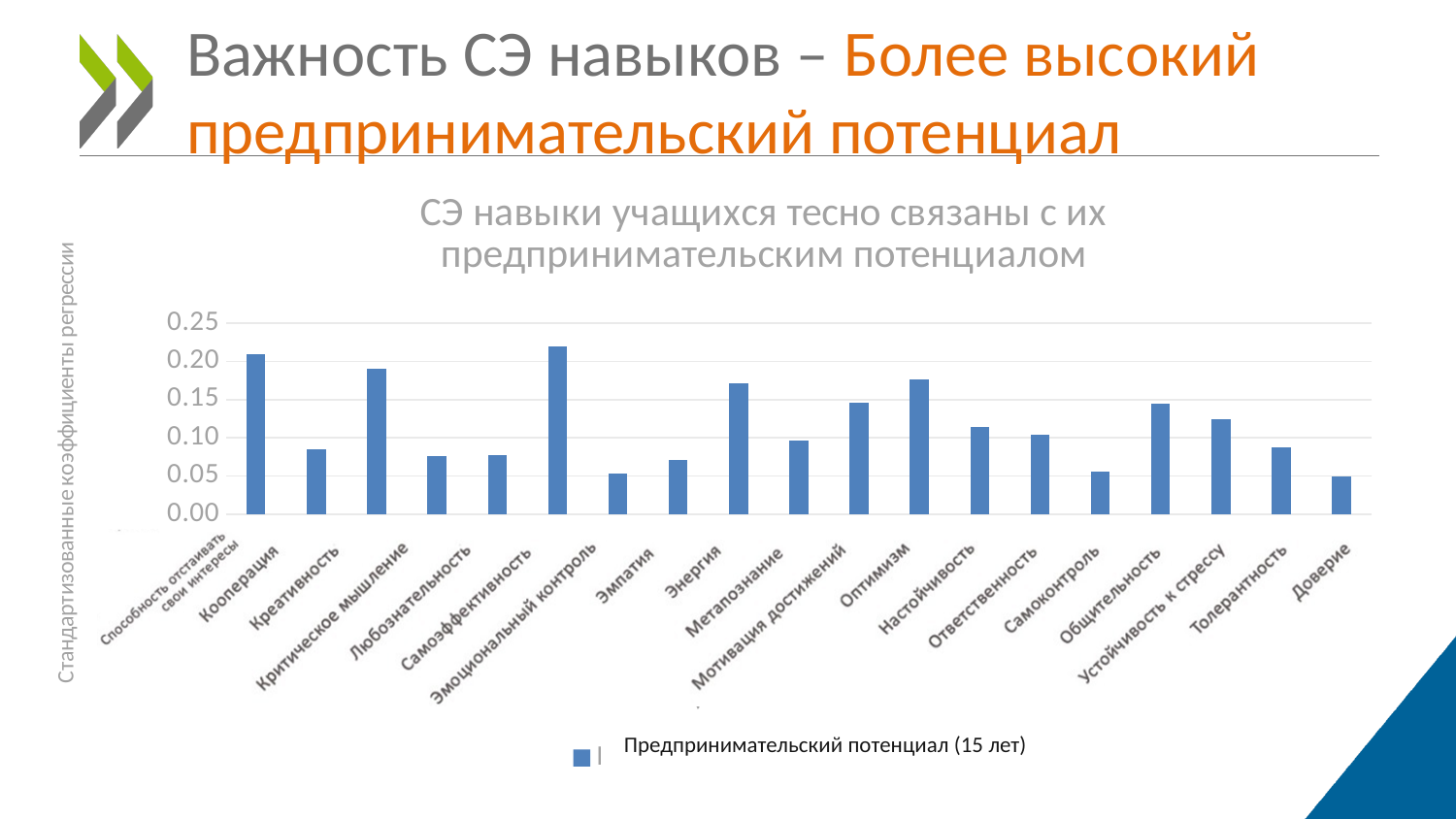
Is the value for Креативность greater or less than 0.15? greater Is the value for Самоконтроль greater or less than 0.10? less How many series does the chart's legend list? 1 Is the value for Устойчивость к стрессу greater or less than 0.10? greater What is the label of the vertical axis of the chart? Стандартизованные коэффициенты регрессии What is the legend entry of the chart? Предпринимательский потенциал (15 лет) How many categories (skills) are plotted on the x axis of the chart? 19 Which has the larger value, Оптимизм or Метапознание? Оптимизм What kind of chart is shown on the slide? Bar chart Which has the larger value, Креативность or Кооперация? Креативность